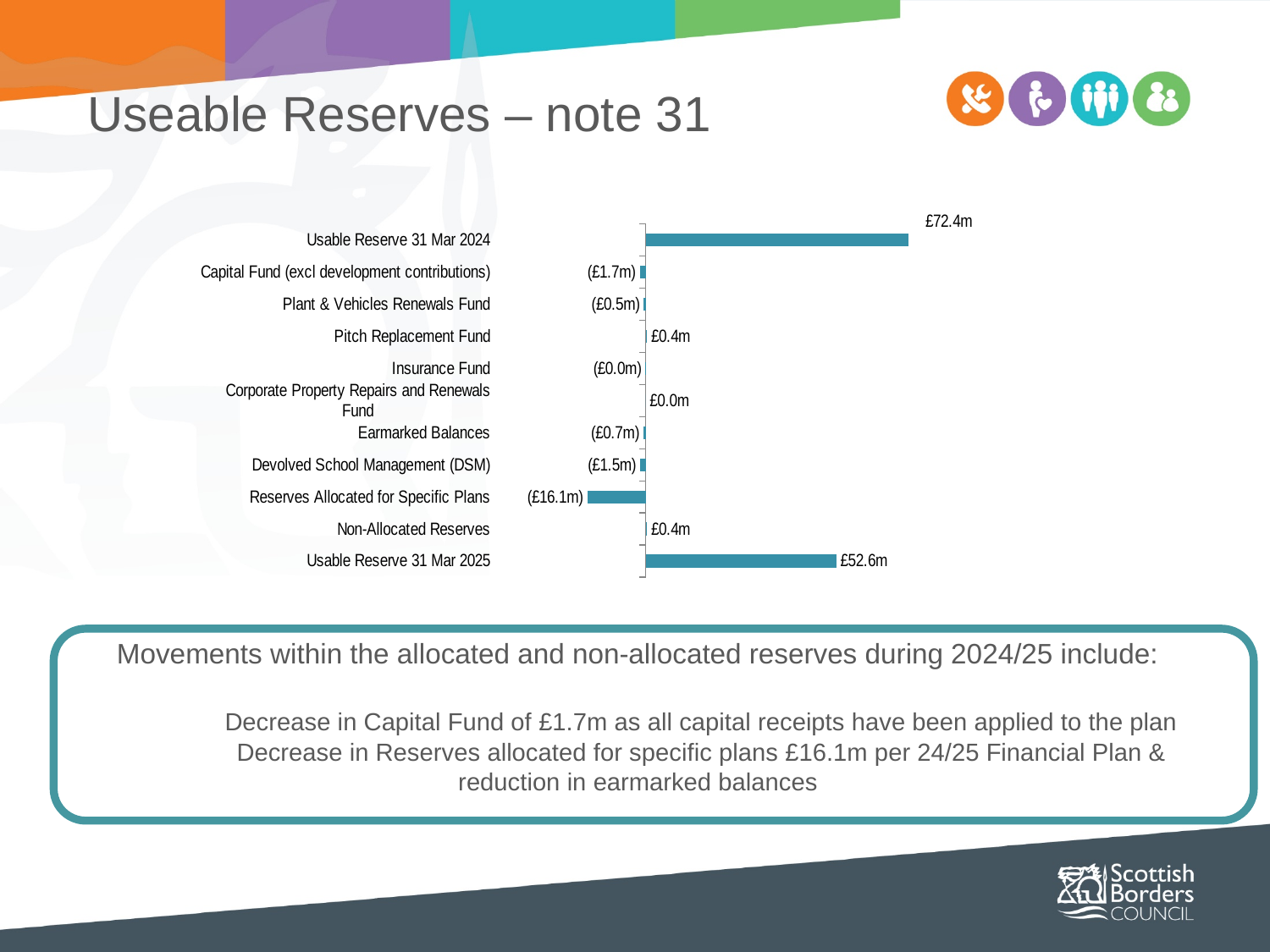
Which is larger in magnitude, the decrease for Capital Fund (excl development contributions) or the decrease for Devolved School Management (DSM)? Capital Fund (excl development contributions) What is the value shown for Capital Fund (excl development contributions)? (£1.7m) Which category has the highest value in the chart? Usable Reserve 31 Mar 2024 What is the value shown for Reserves Allocated for Specific Plans? (£16.1m) What is the value shown for Usable Reserve 31 Mar 2025? £52.6m What is the value shown for Usable Reserve 31 Mar 2024? £72.4m What is the value shown for Devolved School Management (DSM)? (£1.5m) By how much is the Usable Reserve 31 Mar 2024 larger than the Usable Reserve 31 Mar 2025? £19.8m What is the value shown for Earmarked Balances? (£0.7m) What type of chart is shown on the slide? Bar chart How many categories are plotted in the chart? 11 Which category has the largest negative value (the lowest value) in the chart? Reserves Allocated for Specific Plans